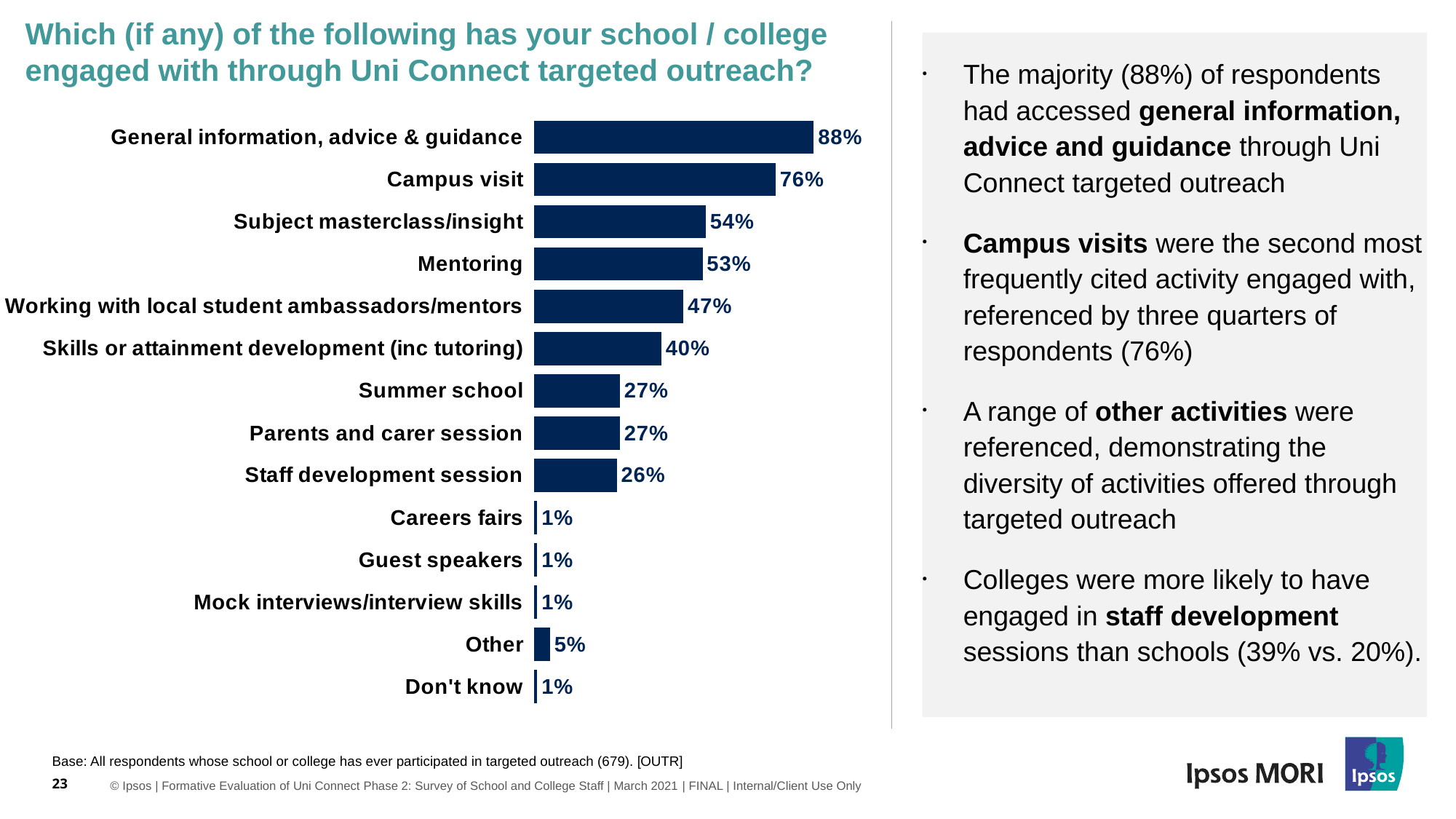
What kind of chart is shown on the slide? Bar chart What is the value for Staff development session? 26% Which category has the highest value in the chart? General information, advice & guidance Which is larger: the value for Working with local student ambassadors/mentors or the value for Skills or attainment development (inc tutoring)? Working with local student ambassadors/mentors What percentage of respondents said their school / college engaged with a campus visit through Uni Connect targeted outreach? 76% What is the value shown for Other? 5% What is the value shown for Mentoring? 53% What is the difference in percentage points between General information, advice & guidance and Campus visit? 12 What percentage is shown for Skills or attainment development (inc tutoring)? 40% How many categories are shown in the chart? 14 What is the difference in percentage points between Subject masterclass/insight and Summer school? 27 What is the base size stated below the chart? 679